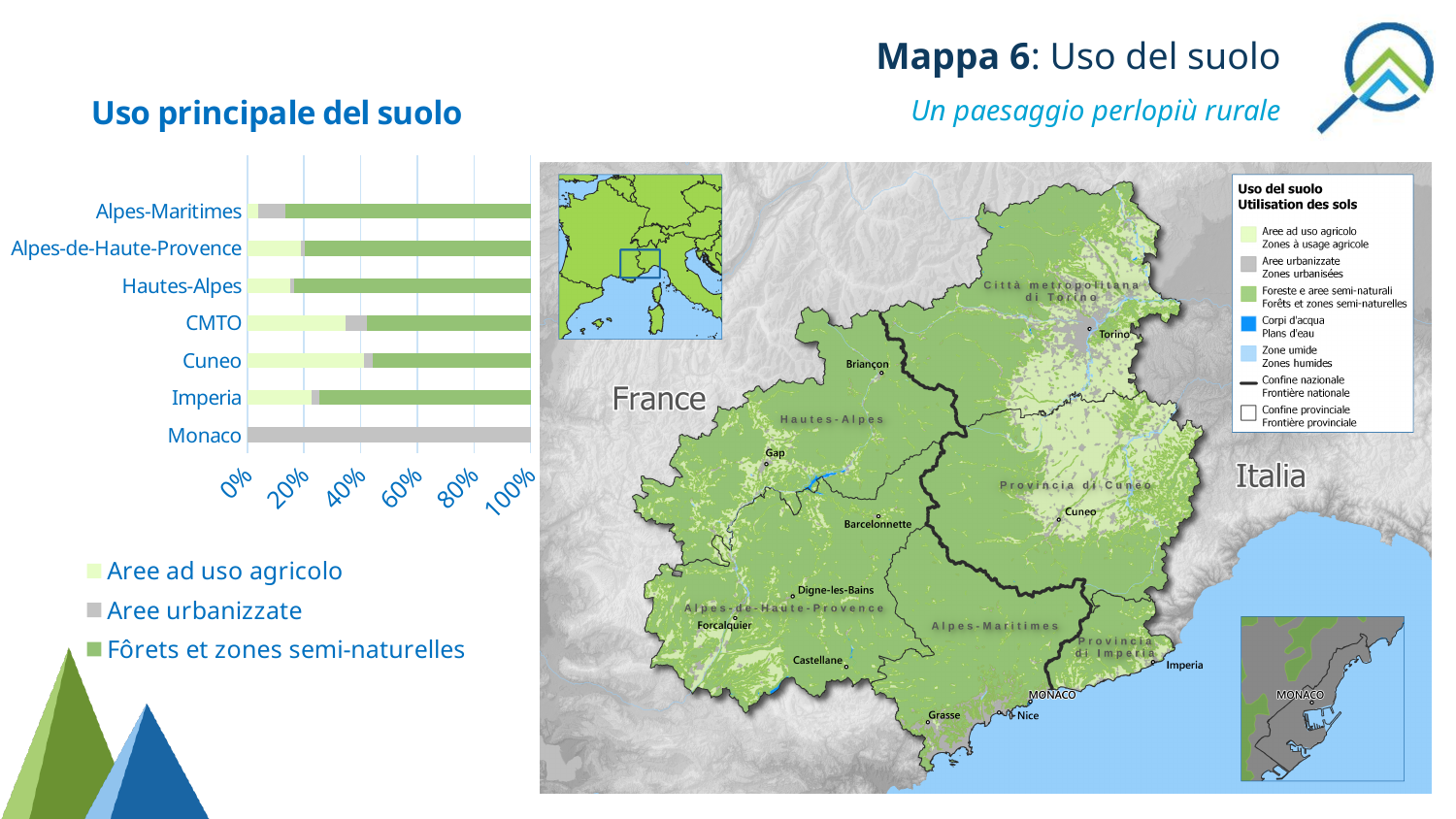
In the 'Uso principale del suolo' chart, is the 'Aree ad uso agricolo' share for Alpes-Maritimes greater or less than 20%? less In the 'Uso principale del suolo' chart, which territory has the largest share of 'Aree ad uso agricolo'? Cuneo How many series does the legend of the 'Uso principale del suolo' chart list? 3 In the 'Uso principale del suolo' chart, which series is shown in grey? Aree urbanizzate What type of chart is 'Uso principale del suolo'? Stacked bar chart How many categories (territories) are shown in the 'Uso principale del suolo' chart? 7 In the 'Uso principale del suolo' chart, is the 'Fôrets et zones semi-naturelles' share for Alpes-Maritimes greater or less than 60%? greater What is the highest value shown on the x axis of the 'Uso principale del suolo' chart? 100% In the 'Uso principale del suolo' chart, which has a larger 'Aree urbanizzate' share: Monaco or Imperia? Monaco In the 'Uso principale del suolo' chart, is the 'Aree ad uso agricolo' share for Cuneo greater or less than 20%? greater In the 'Uso principale del suolo' chart, which territory's bar is made up entirely of 'Aree urbanizzate'? Monaco In the 'Uso principale del suolo' chart, which has a larger 'Aree ad uso agricolo' share: Cuneo or Hautes-Alpes? Cuneo